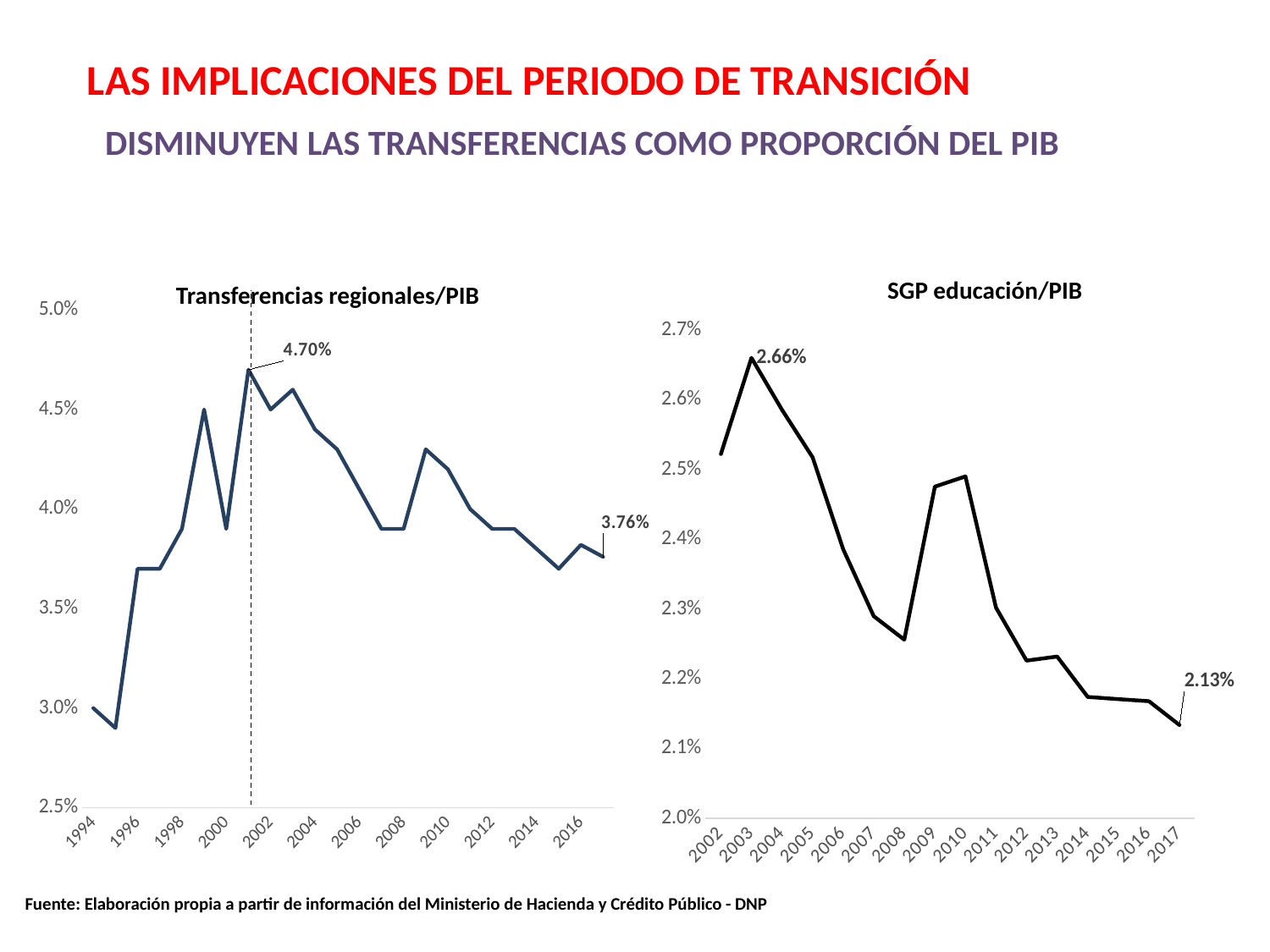
How many data points are plotted in the 'SGP educación/PIB' chart? 16 In the 'SGP educación/PIB' chart, which year has the highest value? 2003 What type of chart is the 'SGP educación/PIB' chart? Line chart In the 'SGP educación/PIB' chart, what is the value labeled for 2017? 2.13% In the 'SGP educación/PIB' chart, which year has the lowest value? 2017 In the 'SGP educación/PIB' chart, what is the difference between the 2003 value and the 2017 value? 0.53 percentage points In the 'Transferencias regionales/PIB' chart, what is the peak value labeled on the line? 4.70% In the 'SGP educación/PIB' chart, is the value for 2014 greater or less than 2.2%? less In the 'SGP educación/PIB' chart, what is the value labeled for 2003? 2.66% In the 'Transferencias regionales/PIB' chart, what is the difference between the labeled peak value and the labeled 2017 value? 0.94 percentage points In the 'Transferencias regionales/PIB' chart, is the value for 2009 greater or less than 4.0%? greater In the 'Transferencias regionales/PIB' chart, what value is labeled at the end of the series in 2017? 3.76%